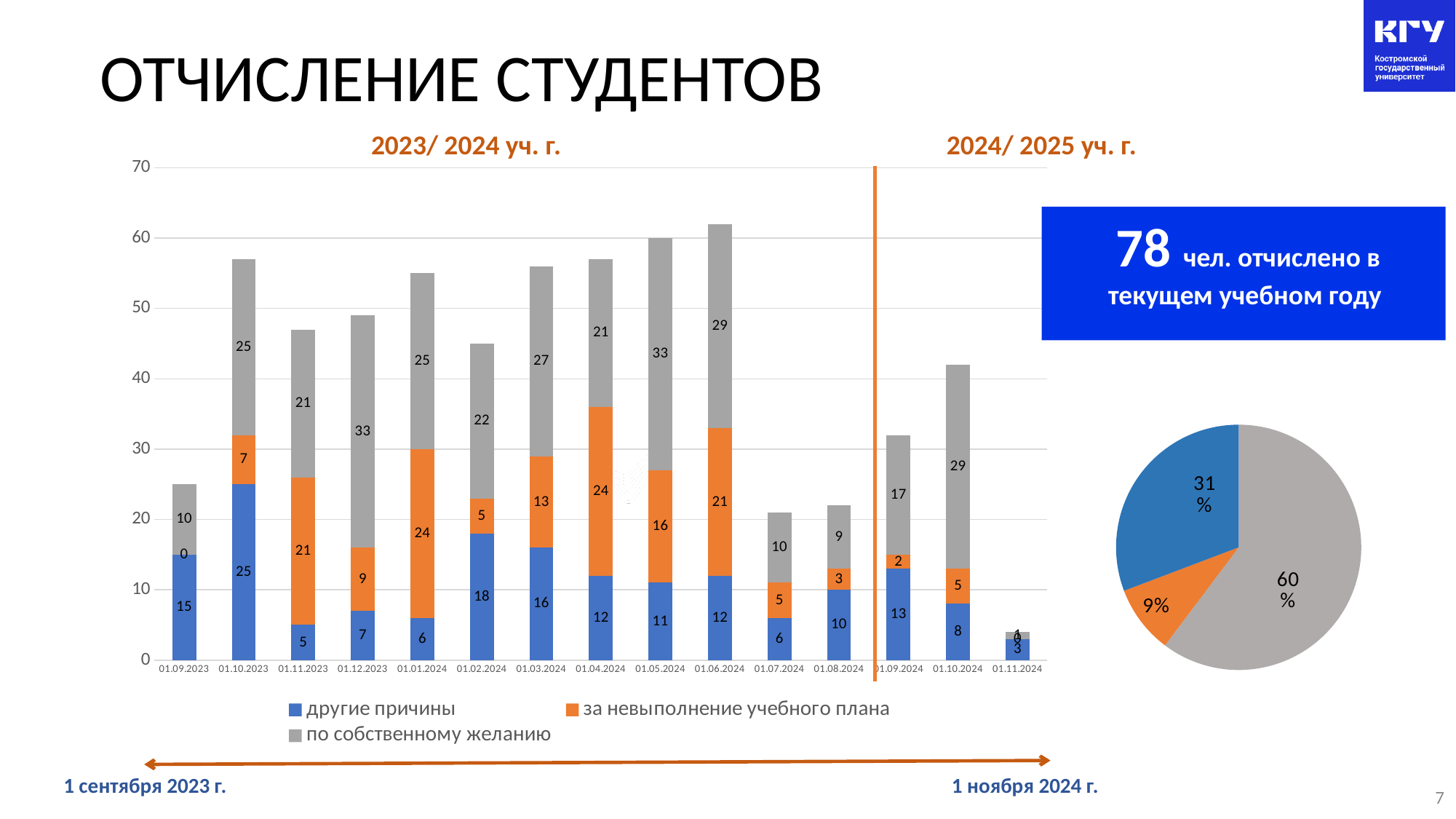
In the stacked bar chart, what is the total of the stacked bar for 01.09.2024? 32 In the stacked bar chart, which date has the lowest value for 'за невыполнение учебного плана' among the 2023/2024 academic year bars? 01.09.2023 In the pie chart, what share does the gray slice represent? 60% How many dates are shown on the x axis of the stacked bar chart? 15 In the stacked bar chart, which date has the highest value for 'по собственному желанию'? 01.12.2023 and 01.05.2024 (33 each) In the stacked bar chart, what is the value for 'другие причины' on 01.10.2023? 25 In the stacked bar chart, what is the value for 'по собственному желанию' on 01.05.2024? 33 In the stacked bar chart, what is the difference between the 'другие причины' values on 01.10.2023 and 01.11.2023? 20 How many series does the legend of the stacked bar chart list? 3 In the stacked bar chart, what is the total of the stacked bar for 01.06.2024? 62 In the stacked bar chart, which is larger: 'по собственному желанию' on 01.06.2024 or on 01.10.2024? 01.06.2024 and 01.10.2024 are equal (29 each) In the stacked bar chart, what is the value for 'за невыполнение учебного плана' on 01.04.2024? 24